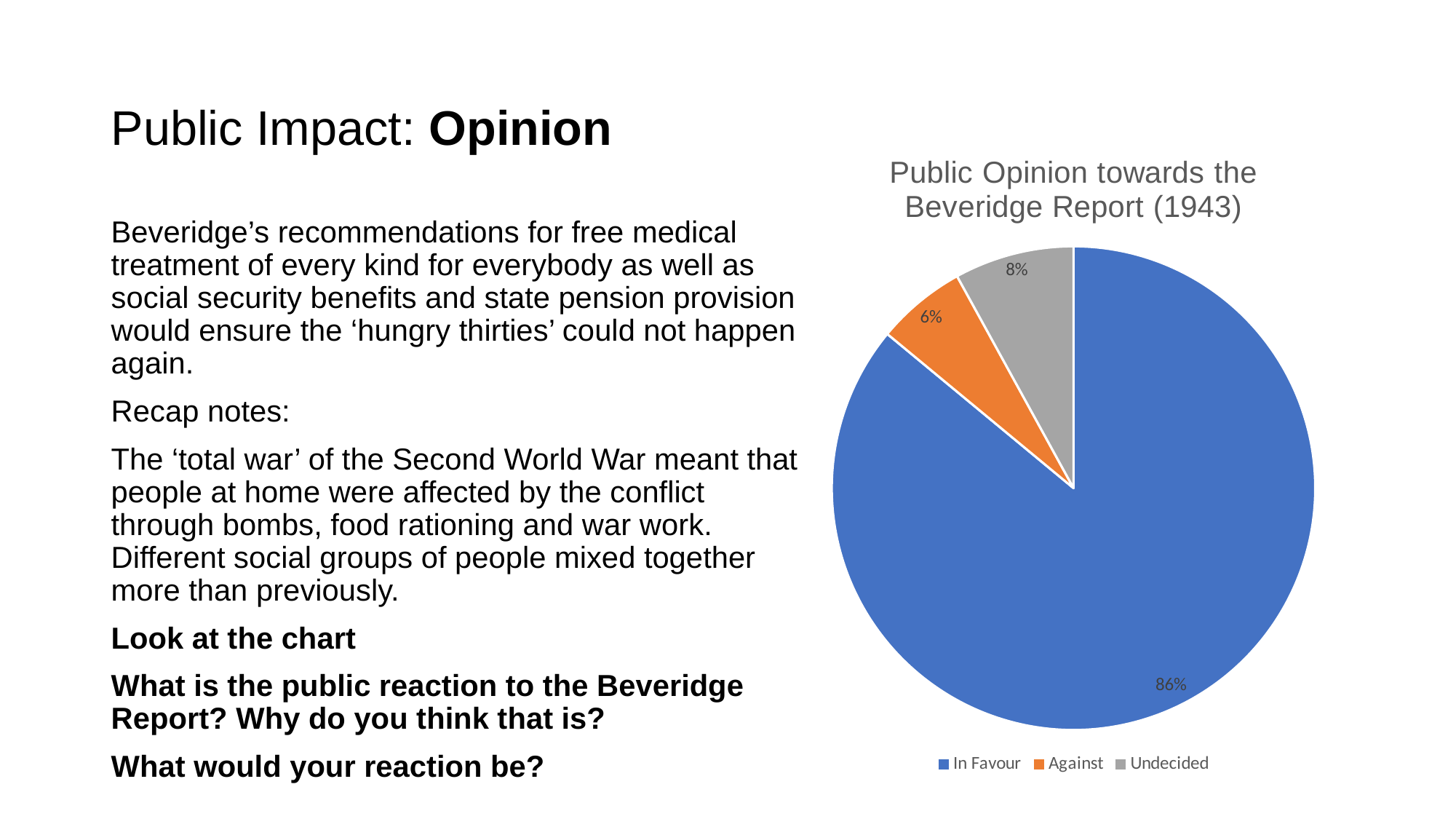
Which category has the largest share of the pie? In Favour Which category has the smallest share of the pie? Against What percentage of the public was Undecided about the Beveridge Report? 8% What percentage of the public was Against the Beveridge Report? 6% What kind of chart is shown on the slide? pie chart What percentage of the public was In Favour of the Beveridge Report? 86% What is the difference between the Undecided share and the Against share? 2% How many categories does the pie chart show? 3 Which colour represents the Against category in the legend? orange What is the title of the chart? Public Opinion towards the Beveridge Report (1943) What is the difference between the In Favour share and the Undecided share? 78% Which is larger, the Against share or the Undecided share? Undecided